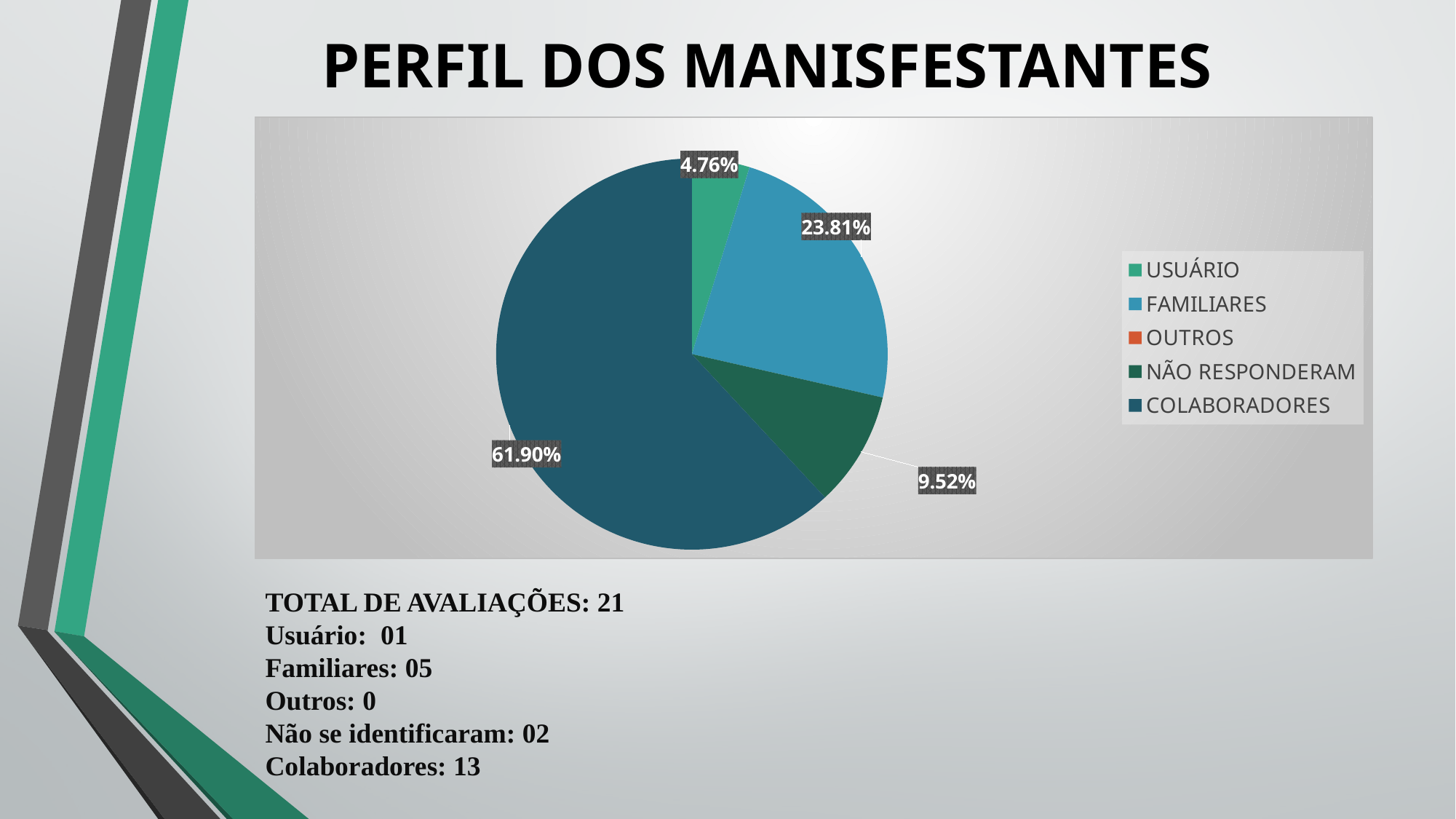
What is the difference in percentage points between the COLABORADORES slice and the FAMILIARES slice? 38.09 What percentage of the pie does COLABORADORES represent? 61.90% What percentage of the pie does NÃO RESPONDERAM represent? 9.52% Which is larger, the share for FAMILIARES or the share for NÃO RESPONDERAM? FAMILIARES What is the title of the slide containing the chart? PERFIL DOS MANISFESTANTES How many entries does the legend list? 5 What percentage of the pie does FAMILIARES represent? 23.81% What percentage of the pie does USUÁRIO represent? 4.76% Which category has the largest slice of the pie? COLABORADORES What kind of chart is shown on the slide? pie chart Which category with a visible slice has the smallest share of the pie? USUÁRIO Which legend entry has no visible slice in the pie? OUTROS